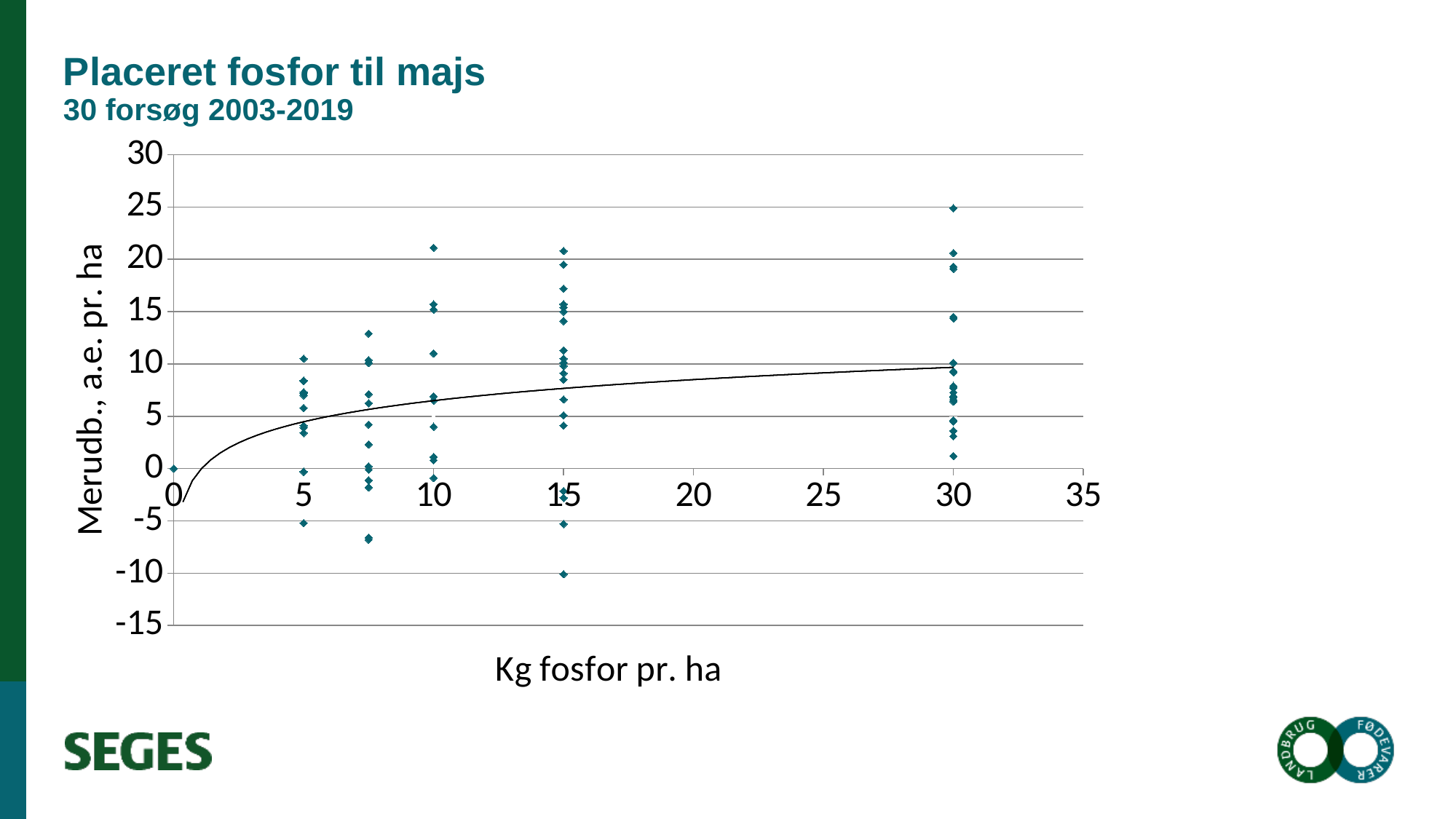
Is the value of the fitted curve at 15 Kg fosfor pr. ha greater or less than 5? greater What is the title of the chart on the slide? Placeret fosfor til majs Does the fitted curve rise or fall as Kg fosfor pr. ha increases? Rises Is the highest data point at 10 Kg fosfor pr. ha greater or less than 20? greater Is the value of the fitted curve at 30 Kg fosfor pr. ha greater or less than 15? less What kind of chart is shown on the slide? Scatter plot At which Kg fosfor pr. ha value is the single highest data point plotted? 30 What is the label of the x axis? Kg fosfor pr. ha At which Kg fosfor pr. ha value is the single lowest data point plotted? 15 What is the highest value shown on the y axis? 30